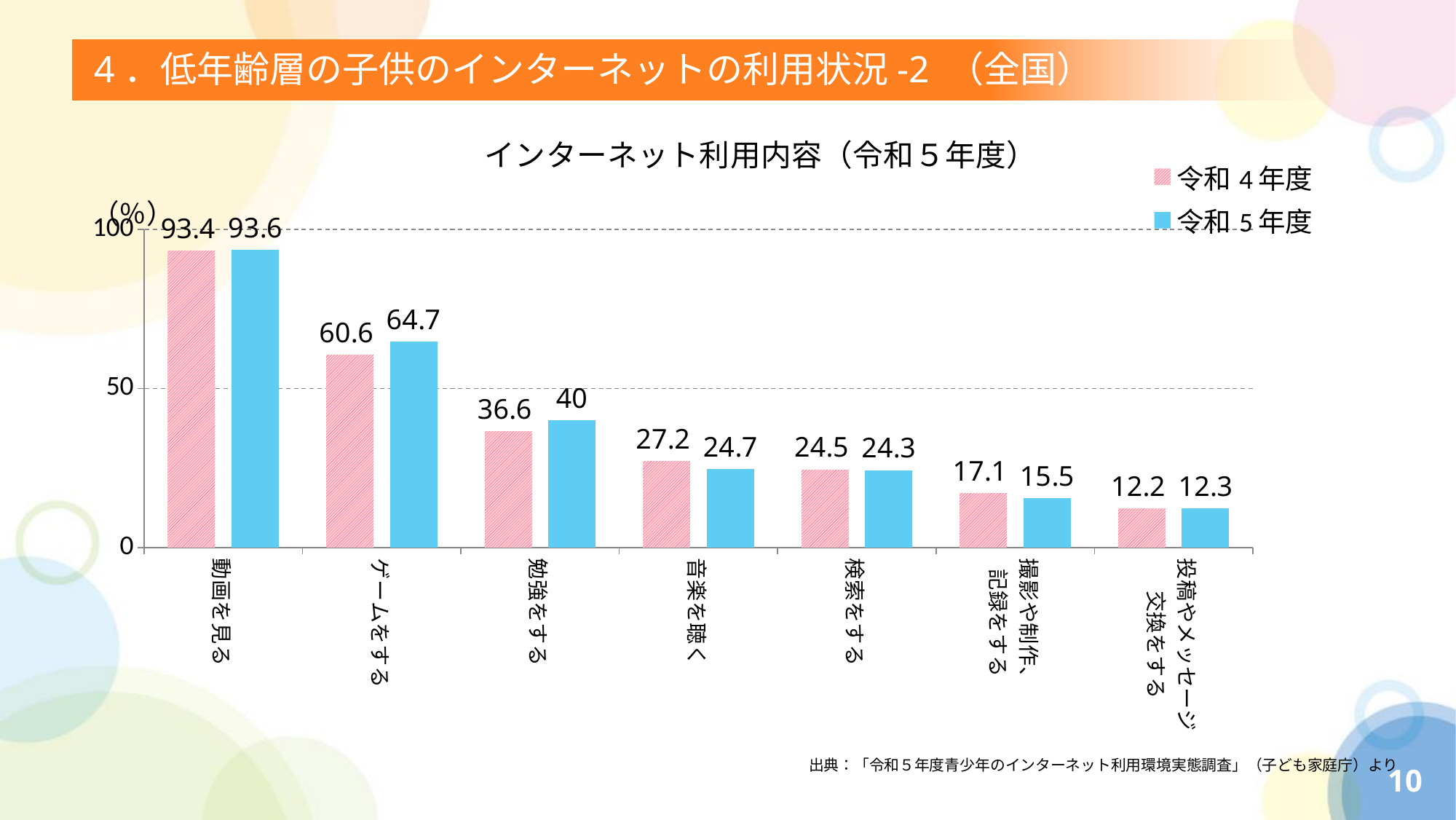
What is the 令和4年度 value for ゲームをする? 60.6 For 音楽を聴く, which is larger: the 令和4年度 value or the 令和5年度 value? 令和4年度 What is the 令和5年度 value for 勉強をする? 40 What is the title of the chart? インターネット利用内容（令和5年度） Do the 令和5年度 values rise or fall from left to right along the x axis? fall What kind of chart is shown on the slide? bar chart How many categories are shown on the x axis? 7 Which category has the lowest 令和4年度 value? 投稿やメッセージ交換をする What is the 令和5年度 value for 動画を見る? 93.6 How many series does the legend list? 2 What is the difference between the 令和5年度 and 令和4年度 values for ゲームをする? 4.1 Which category has the highest 令和5年度 value? 動画を見る